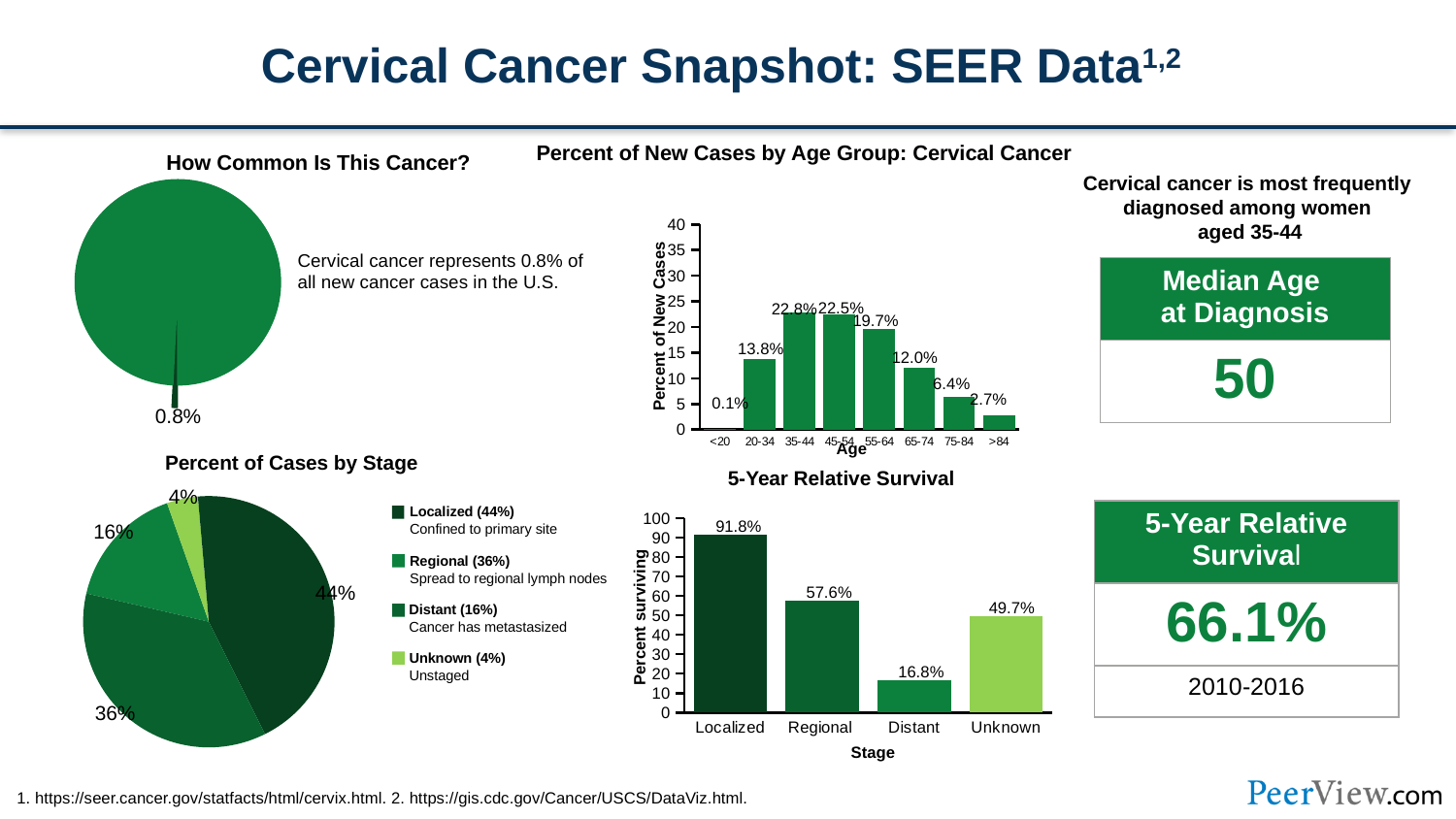
What kind of chart is the '5-Year Relative Survival' chart? bar chart In the '5-Year Relative Survival' chart, which is larger, the value for Unknown or the value for Distant? Unknown In the 'Percent of New Cases by Age Group' chart, do the values rise or fall from the 45-54 group to the >84 group? fall In the '5-Year Relative Survival' chart, which stage has the highest survival? Localized In the 'Percent of New Cases by Age Group' chart, what is the difference between the values for 55-64 and 65-74? 7.7% In the 'How Common Is This Cancer?' pie chart, what percent of all new cancer cases does cervical cancer represent? 0.8% In the 'Percent of New Cases by Age Group' chart, what is the value for the 35-44 age group? 22.8% In the 'Percent of Cases by Stage' pie chart, what share of cases is Regional? 36% In the '5-Year Relative Survival' chart, what is the value for Regional? 57.6% In the 'Percent of New Cases by Age Group' chart, which age group has the lowest percent of new cases? <20 In the '5-Year Relative Survival' chart, what is the difference between the values for Localized and Distant? 75.0% In the 'Percent of New Cases by Age Group' chart, how many age groups are shown on the x axis? 8